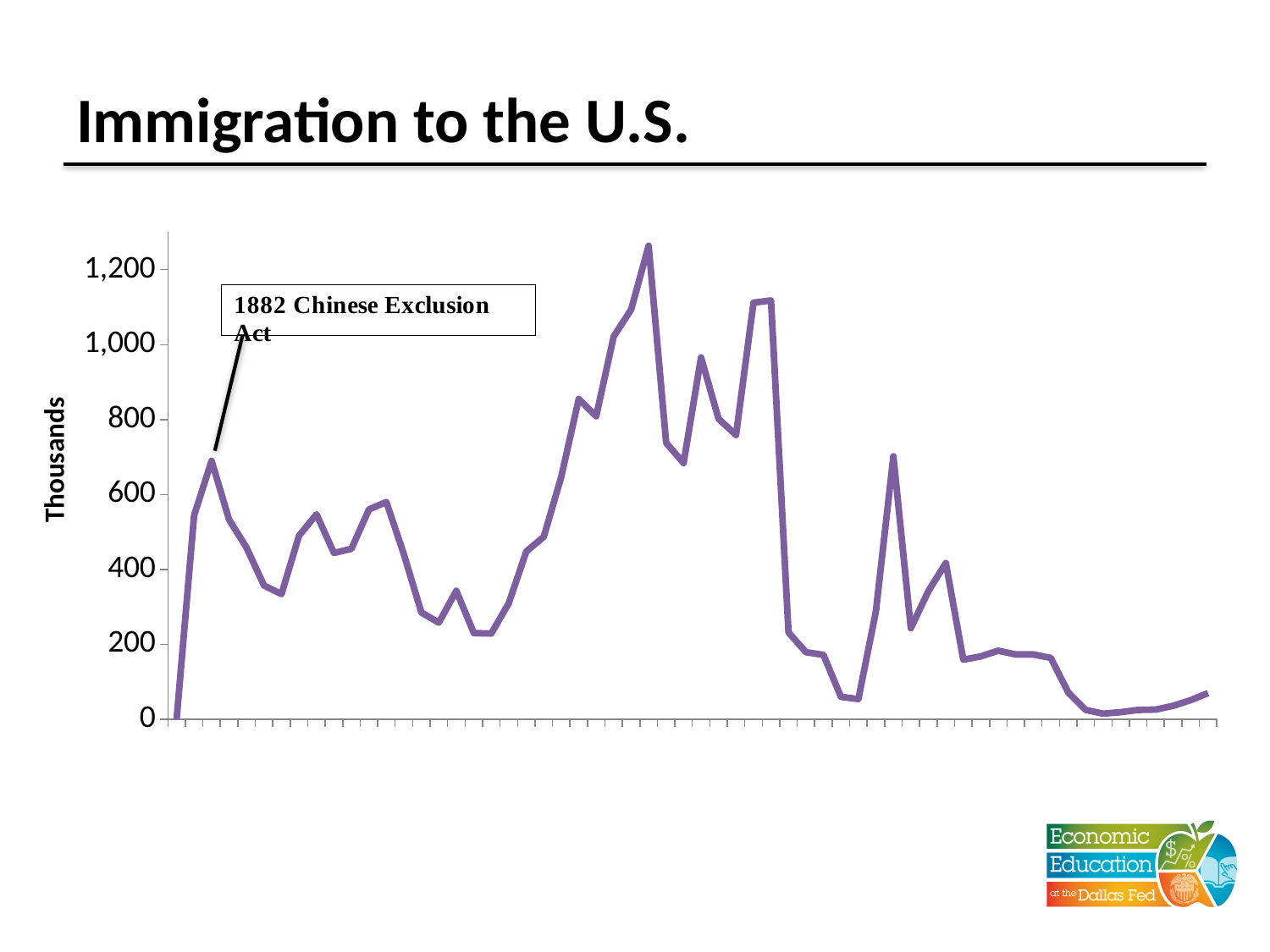
What is the highest value shown on the vertical axis? 1,200 Over the final stretch of the line after its last peak above 600, do the values generally rise or fall? fall What is the title of the chart on the slide? Immigration to the U.S. Is the highest peak of the line greater or less than 1,200? greater What kind of chart is shown on the slide? line chart Is the value at the right-hand end of the line greater or less than 200? less What is the label on the vertical axis of the chart? Thousands Is the value at the point annotated "1882 Chinese Exclusion Act" greater or less than 600? greater Is the value at the point annotated "1882 Chinese Exclusion Act" higher or lower than the overall highest peak of the line? lower